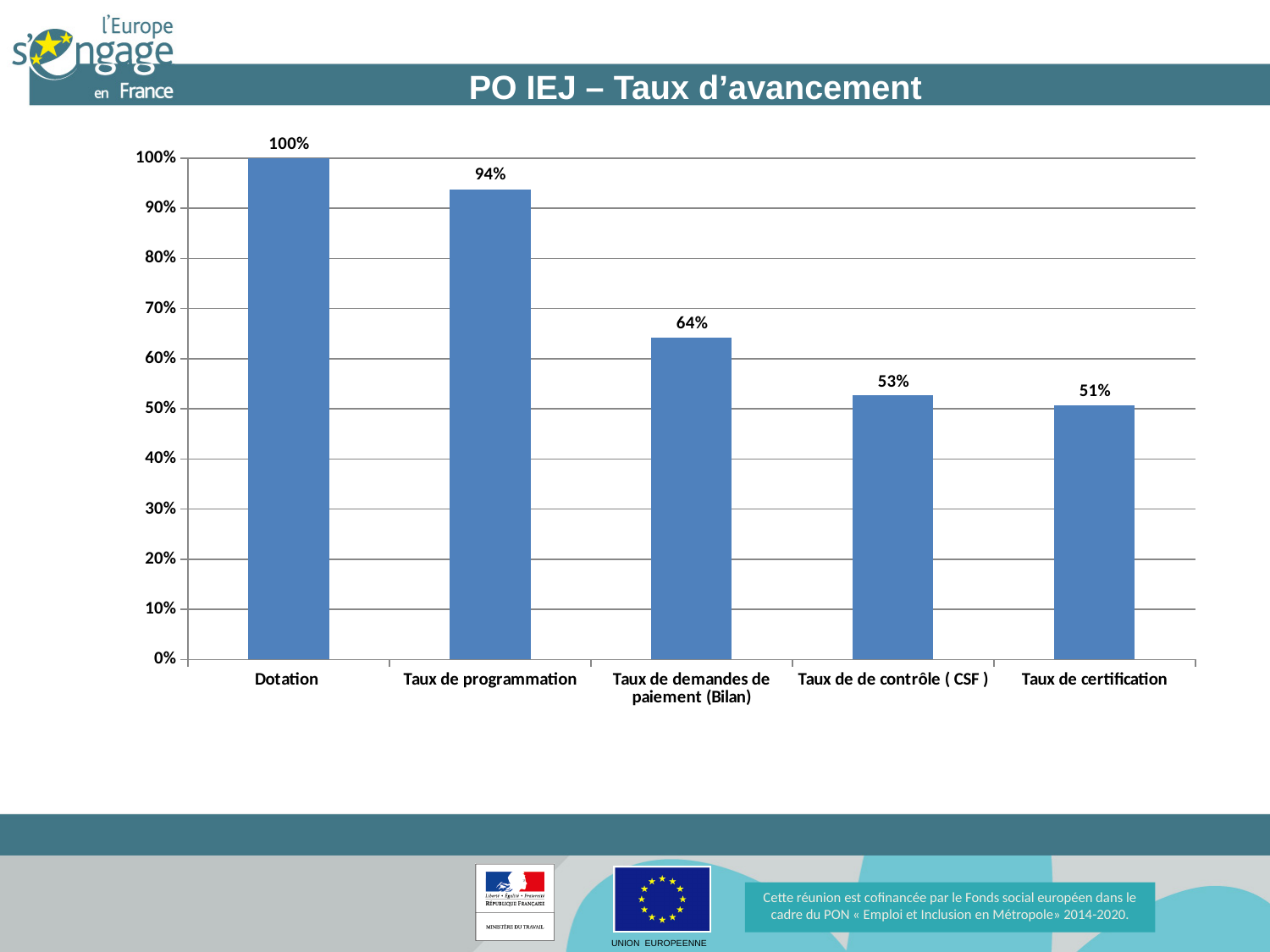
What is the value for Taux de certification? 51% Which is larger, Taux de programmation or Taux de demandes de paiement (Bilan)? Taux de programmation What is the value for Taux de programmation? 94% How many categories are shown on the x axis? 5 Which category has the lowest value? Taux de certification What is the difference between Taux de demandes de paiement (Bilan) and Taux de de contrôle ( CSF )? 11% Do the values rise or fall from left to right along the x axis? fall Is the value for Taux de de contrôle ( CSF ) greater or less than 60%? less What kind of chart is shown on the slide? bar chart What is the difference between Dotation and Taux de programmation? 6% Which category has the highest value? Dotation What is the value for Taux de demandes de paiement (Bilan)? 64%